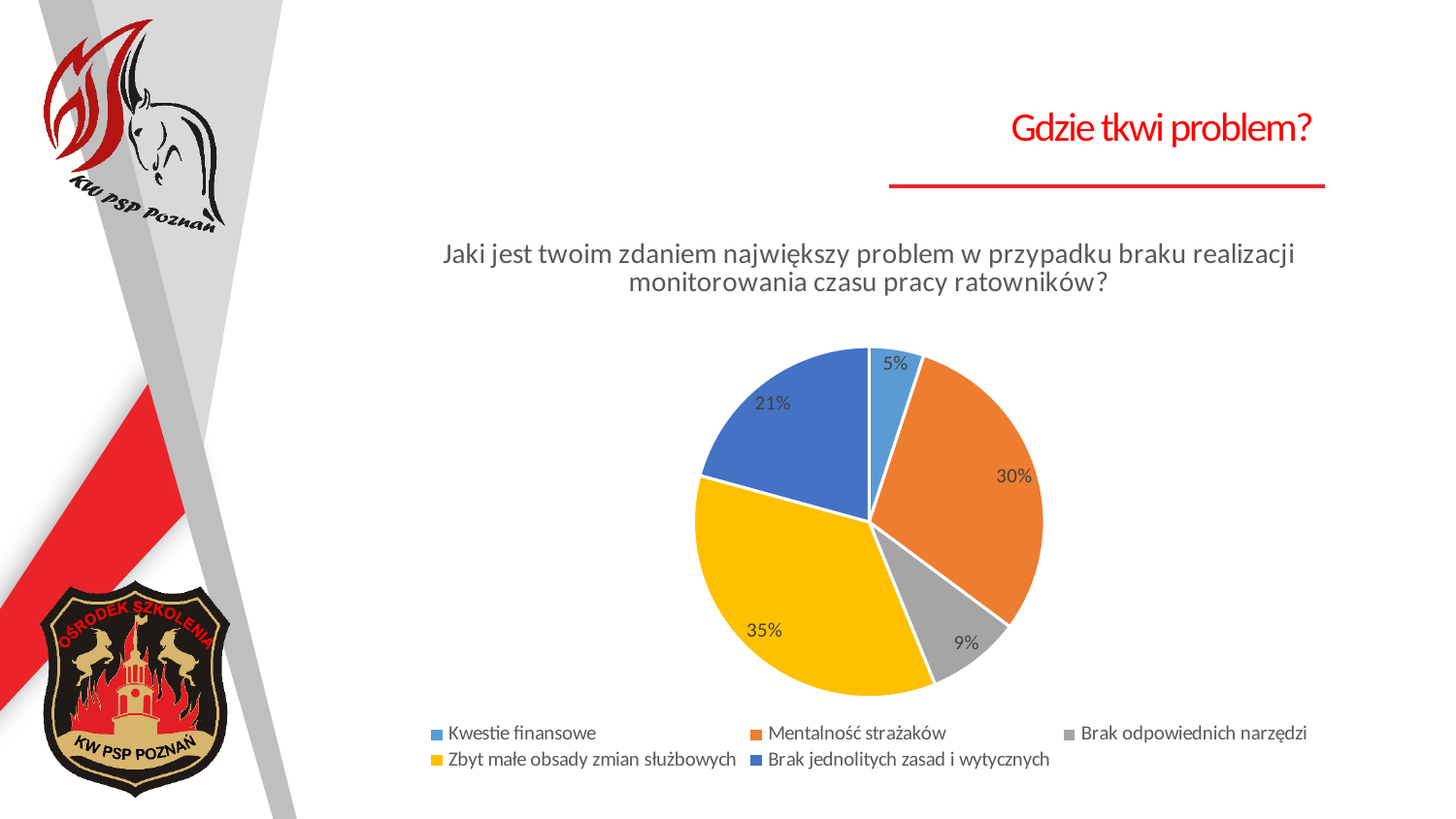
Which is larger: the share for "Brak jednolitych zasad i wytycznych" or the share for "Brak odpowiednich narzędzi"? Brak jednolitych zasad i wytycznych What colour is the slice for "Mentalność strażaków"? orange What is the difference in percentage points between "Zbyt małe obsady zmian służbowych" and "Mentalność strażaków"? 5 What share of the pie does "Brak jednolitych zasad i wytycznych" have? 21% What kind of chart is shown on the slide? pie chart Which category has the smallest slice of the pie? Kwestie finansowe Which category has the largest slice of the pie? Zbyt małe obsady zmian służbowych What share of the pie does "Zbyt małe obsady zmian służbowych" have? 35% What share of the pie does "Brak odpowiednich narzędzi" have? 9% How many categories does the legend of the pie chart list? 5